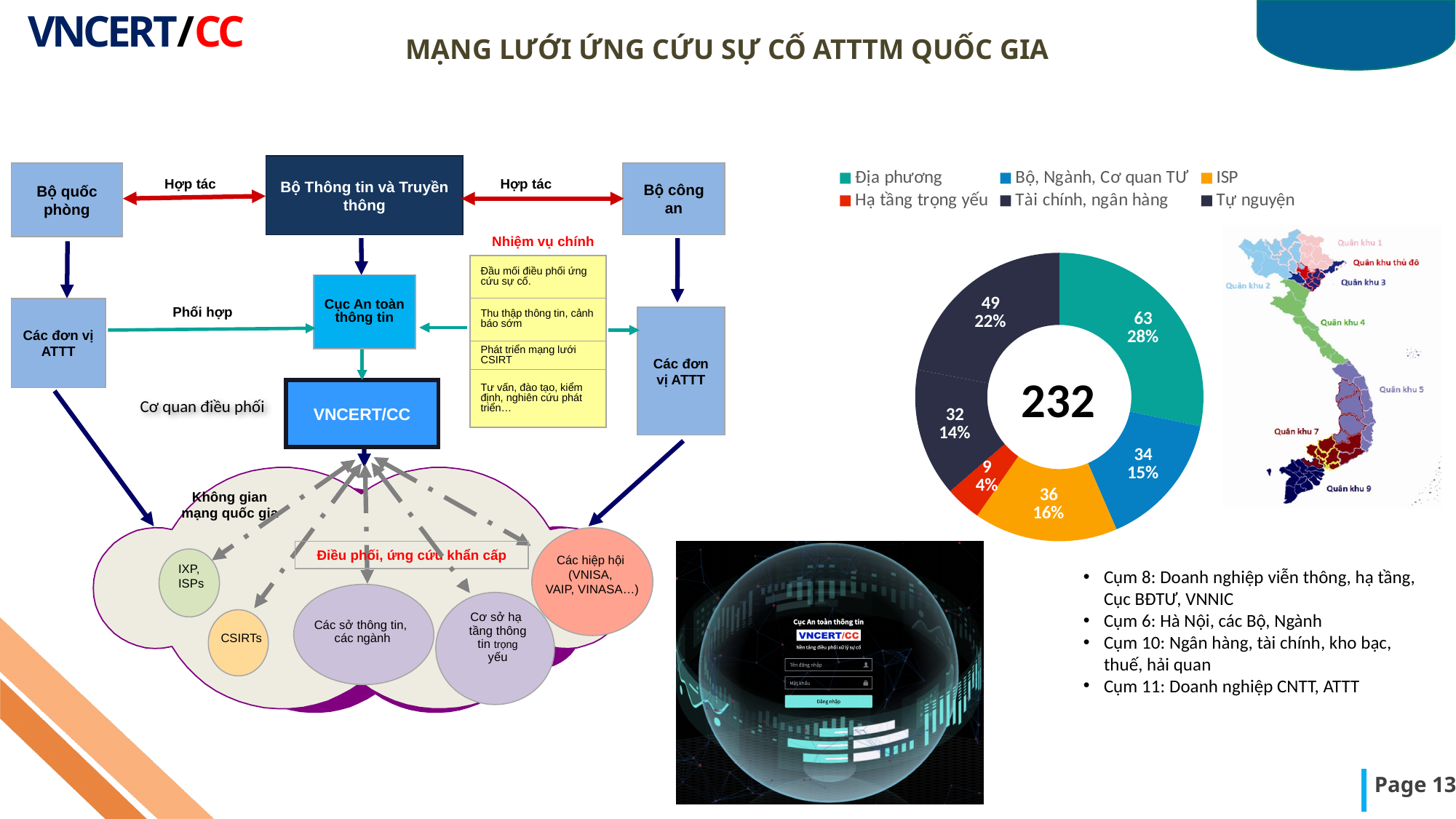
Which category has the smallest slice in the donut chart? Hạ tầng trọng yếu How many categories does the legend of the donut chart list? 6 In the donut chart, what is the value for ISP? 36 In the donut chart, what is the value for Địa phương? 63 In the donut chart, what is the difference between the values for Địa phương and ISP? 27 In the donut chart, what is the value for Bộ, Ngành, Cơ quan TƯ? 34 Which category has the largest slice in the donut chart? Địa phương In the donut chart, what share does Địa phương represent? 28% In the donut chart, which is larger: ISP or Bộ, Ngành, Cơ quan TƯ? ISP In the donut chart, what share does ISP represent? 16% In the donut chart, what is the value for Hạ tầng trọng yếu? 9 What kind of chart is shown on the right side of the slide? pie chart (donut)